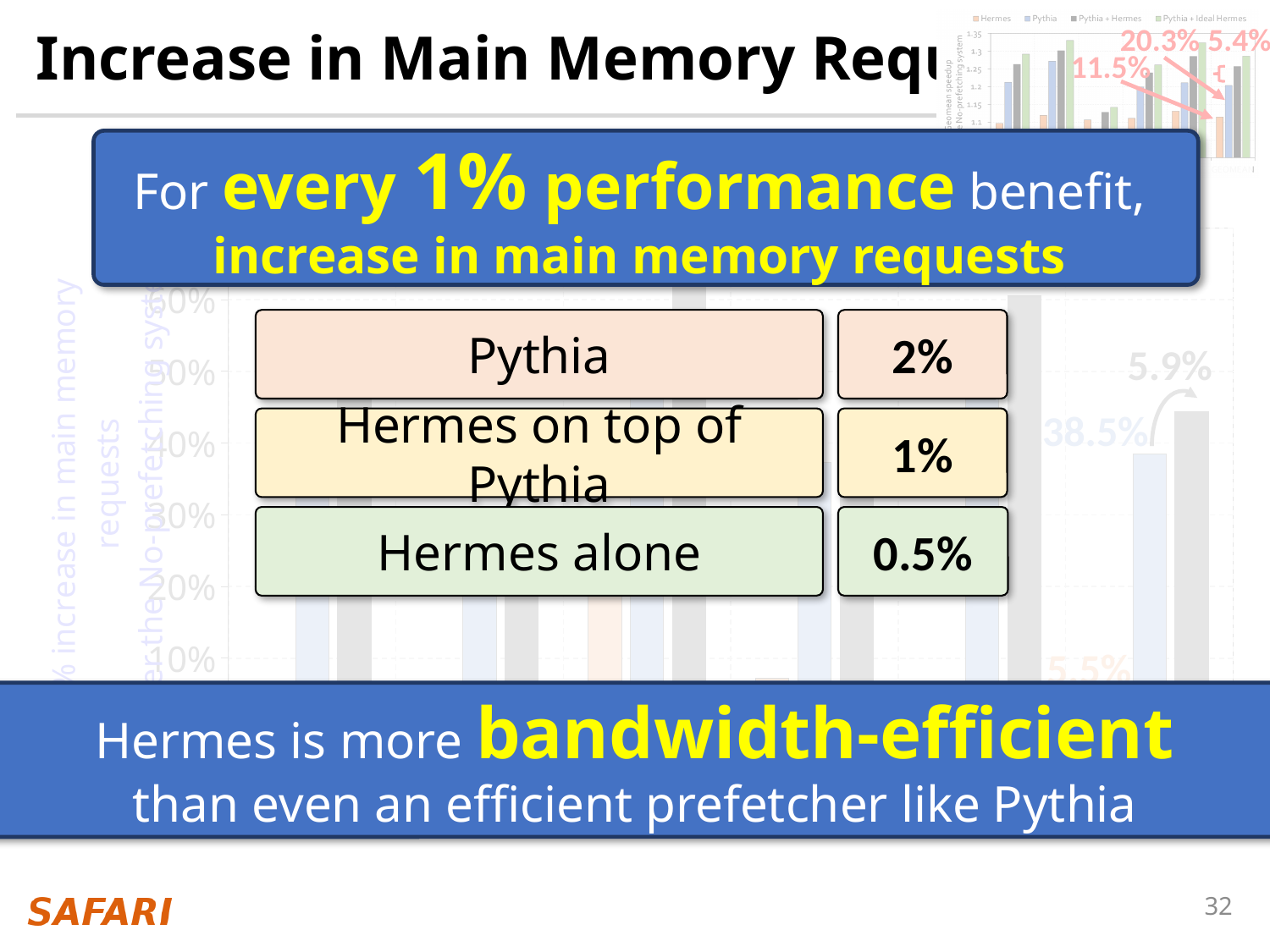
How many series does the legend of the small inset chart in the top-right corner list? 4 In the callout table over the chart, which configuration has the lowest increase in main memory requests per 1% performance benefit? Hermes alone According to the callout table over the chart, what is the increase in main memory requests for every 1% performance benefit for Pythia? 2% In the callout table over the chart, which configuration has the highest increase in main memory requests per 1% performance benefit? Pythia In the callout table over the chart, what is the difference between the value for Pythia and the value for Hermes alone? 1.5% According to the callout table over the chart, what is the increase in main memory requests for every 1% performance benefit for Hermes on top of Pythia? 1% What is the highest y-axis tick shown on the large background chart? 60% According to the callout table over the chart, what is the increase in main memory requests for every 1% performance benefit for Hermes alone? 0.5% What kind of chart is the large faded chart in the background of the slide? bar chart In the callout table over the chart, which is larger: the value for Pythia or the value for Hermes on top of Pythia? Pythia What kind of chart is the small inset chart in the top-right corner of the slide? bar chart What are the legend entries of the small inset chart in the top-right corner? Hermes, Pythia, Pythia + Hermes, Pythia + Ideal Hermes